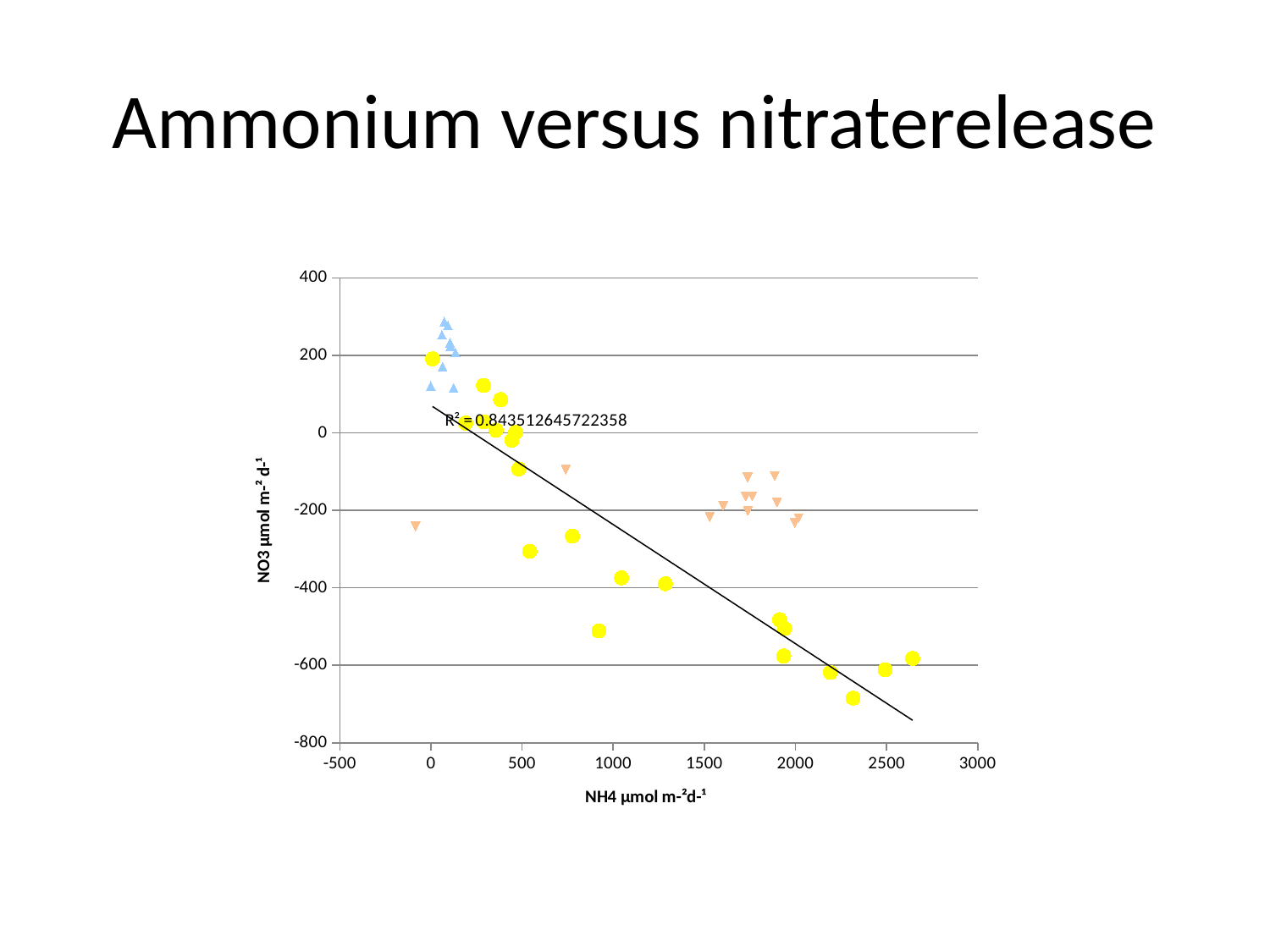
Are the NO3 values of the blue triangle points greater or less than 0? greater What kind of chart is shown on the slide? scatter chart What R² value is printed on the chart? 0.843512645722358 Does the fitted trendline on the chart slope upward or downward from left to right? downward Do the yellow circle points rise or fall in NO3 as NH4 increases along the x axis? fall Is the NO3 value of the yellow point plotted near NH4 = 900 greater or less than -400? less Which marker group reaches the highest NH4 values on the x axis? yellow circles What is the title of the x axis? NH4 µmol m-²d-¹ What is the title of the y axis? NO3 µmol m-² d-¹ Are the NO3 values of the orange triangle points greater or less than 0? less Which group of points has higher NO3 values overall, the blue triangles or the orange triangles? blue triangles